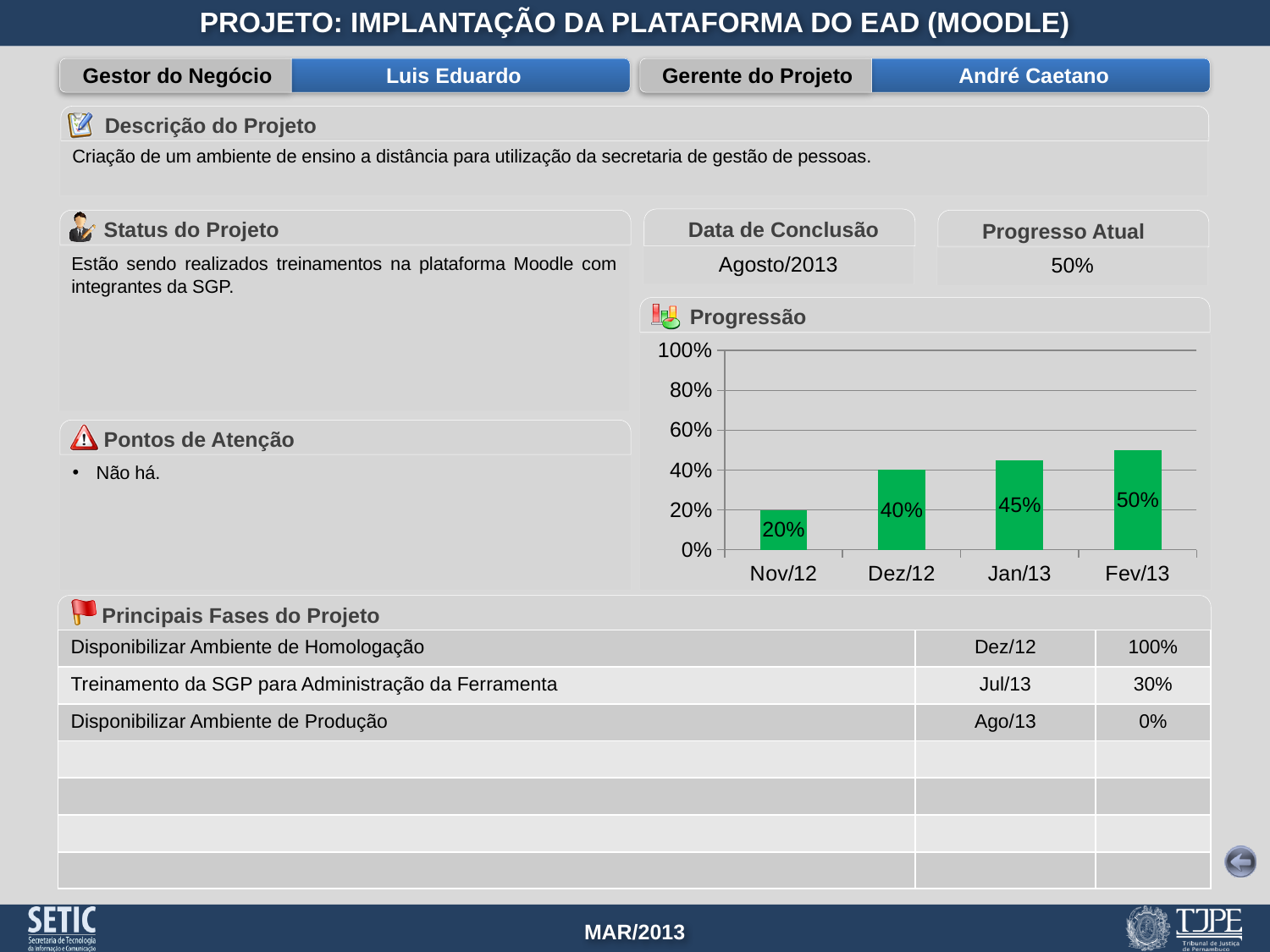
Is the value for Fev/13 in the Progressão chart greater or less than 60%? less Which month has the lowest value in the Progressão chart? Nov/12 What is the value for Dez/12 in the Progressão chart? 40% How many months are shown on the x axis of the Progressão chart? 4 What is the value for Nov/12 in the Progressão chart? 20% What is the difference between the values for Dez/12 and Nov/12 in the Progressão chart? 20% Do the values in the Progressão chart rise or fall from Nov/12 to Fev/13? rise What kind of chart is the Progressão chart? bar chart Which month has the highest value in the Progressão chart? Fev/13 What is the value for Fev/13 in the Progressão chart? 50% Which is larger in the Progressão chart, the value for Jan/13 or Dez/12? Jan/13 What is the value for Jan/13 in the Progressão chart? 45%